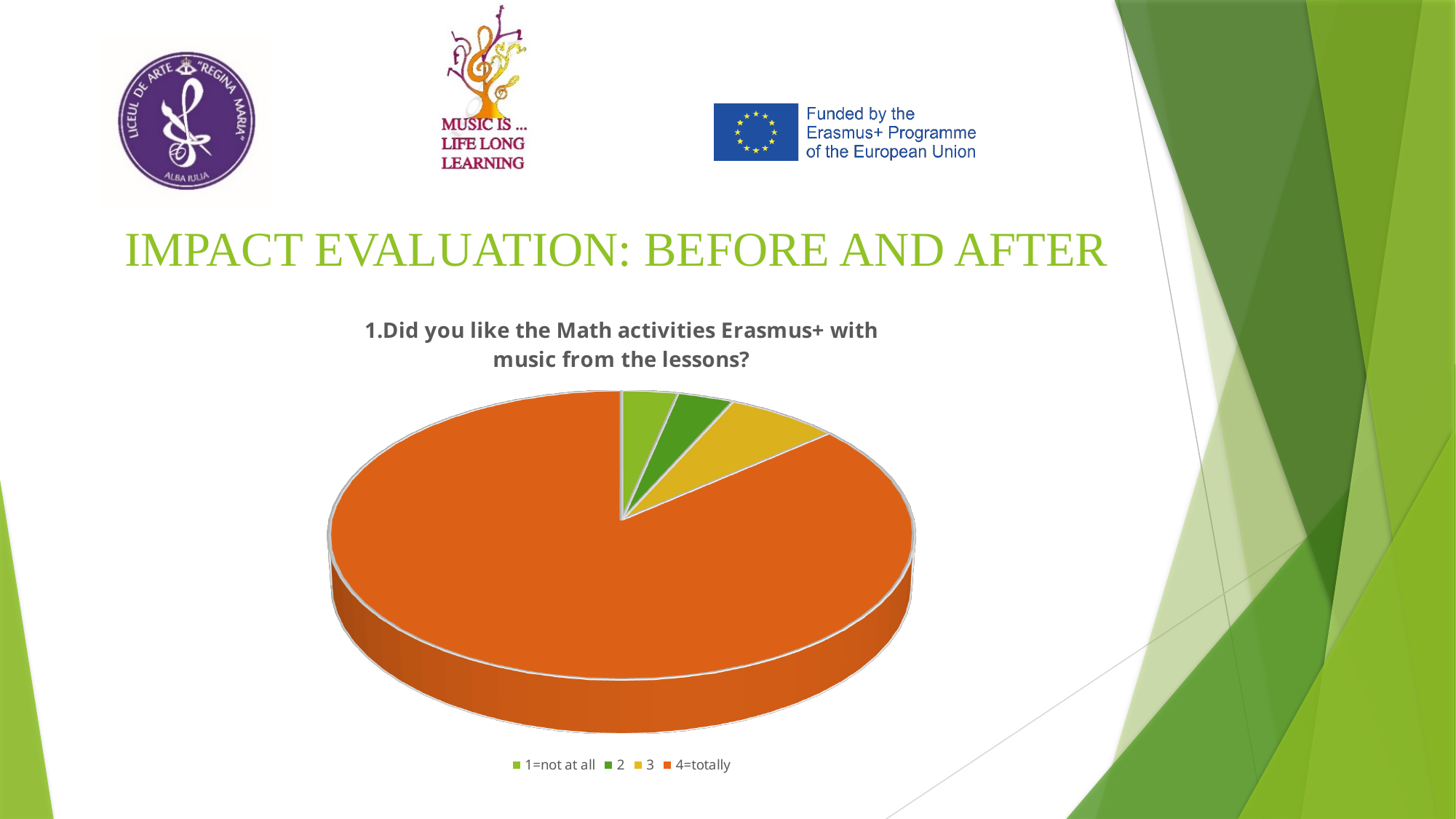
What kind of chart is shown on the slide? pie chart What is the title of the pie chart? 1.Did you like the Math activities Erasmus+ with music from the lessons? How many categories does the legend of the pie chart list? 4 Which colour represents the "4=totally" category in the pie chart? orange Which slice is larger in the pie chart, "4=totally" or "3"? 4=totally Which slice is larger in the pie chart, "3" or "1=not at all"? 3 Which slice is larger in the pie chart, "4=totally" or "2"? 4=totally Which category has the largest slice of the pie chart? 4=totally